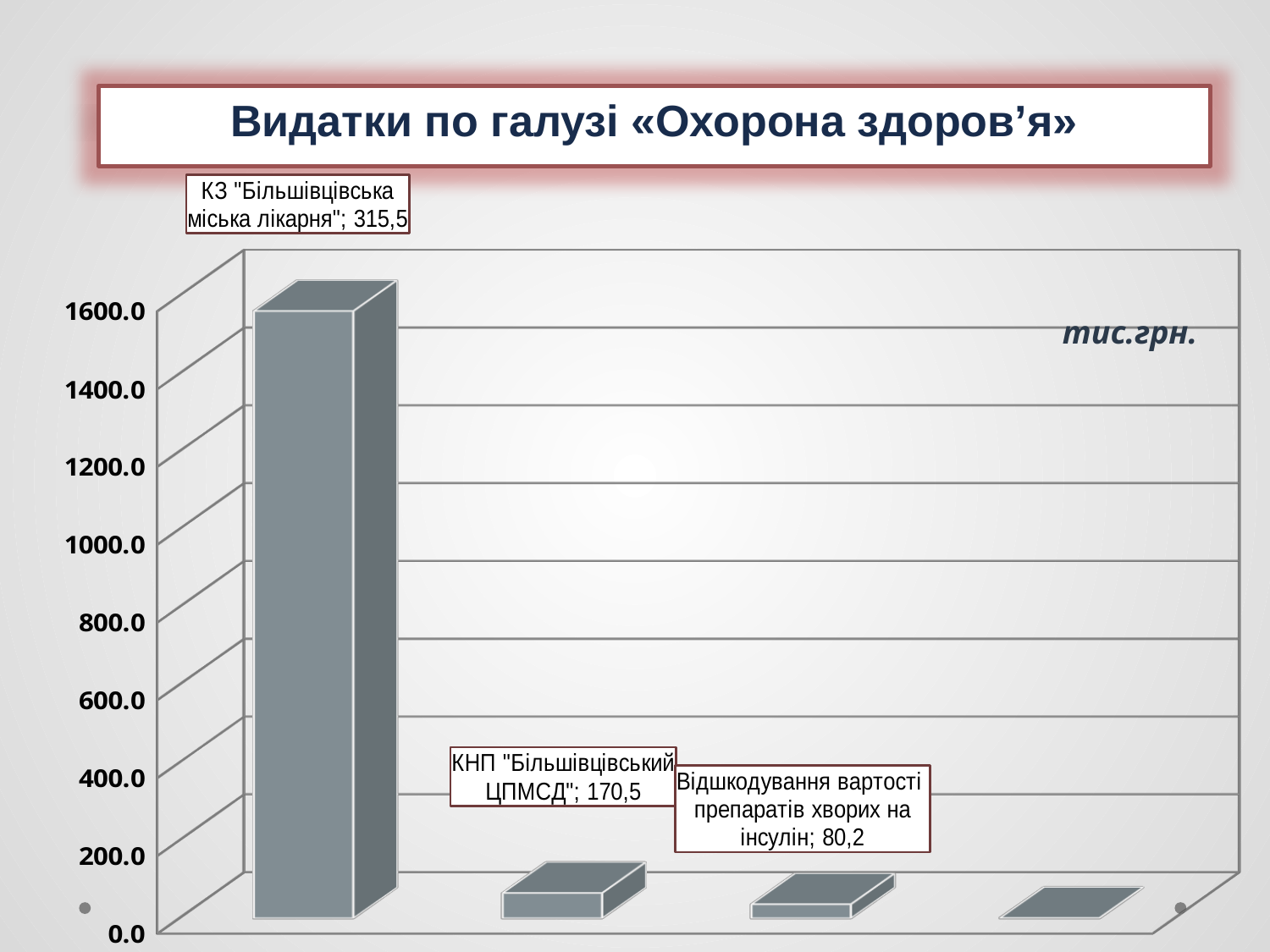
What value is labelled for КНП "Більшівцівський ЦПМСД"? 170,5 Which category has the highest bar? КЗ "Більшівцівська міська лікарня" How many bars are plotted on the chart? 4 What kind of chart is shown on the slide? bar chart What unit is shown on the chart? тис.грн. Which is larger, the labelled value for КНП "Більшівцівський ЦПМСД" or for Відшкодування вартості препаратів хворих на інсулін? КНП "Більшівцівський ЦПМСД" Is the value of the rightmost (unlabelled) bar greater or less than 200? less What is the title of the chart? Видатки по галузі «Охорона здоров’я» What value is labelled for КЗ "Більшівцівська міська лікарня"? 315,5 What is the difference between the labelled values for КЗ "Більшівцівська міська лікарня" and КНП "Більшівцівський ЦПМСД"? 145,0 What value is labelled for Відшкодування вартості препаратів хворих на інсулін? 80,2 What is the difference between the labelled values for КНП "Більшівцівський ЦПМСД" and Відшкодування вартості препаратів хворих на інсулін? 90,3